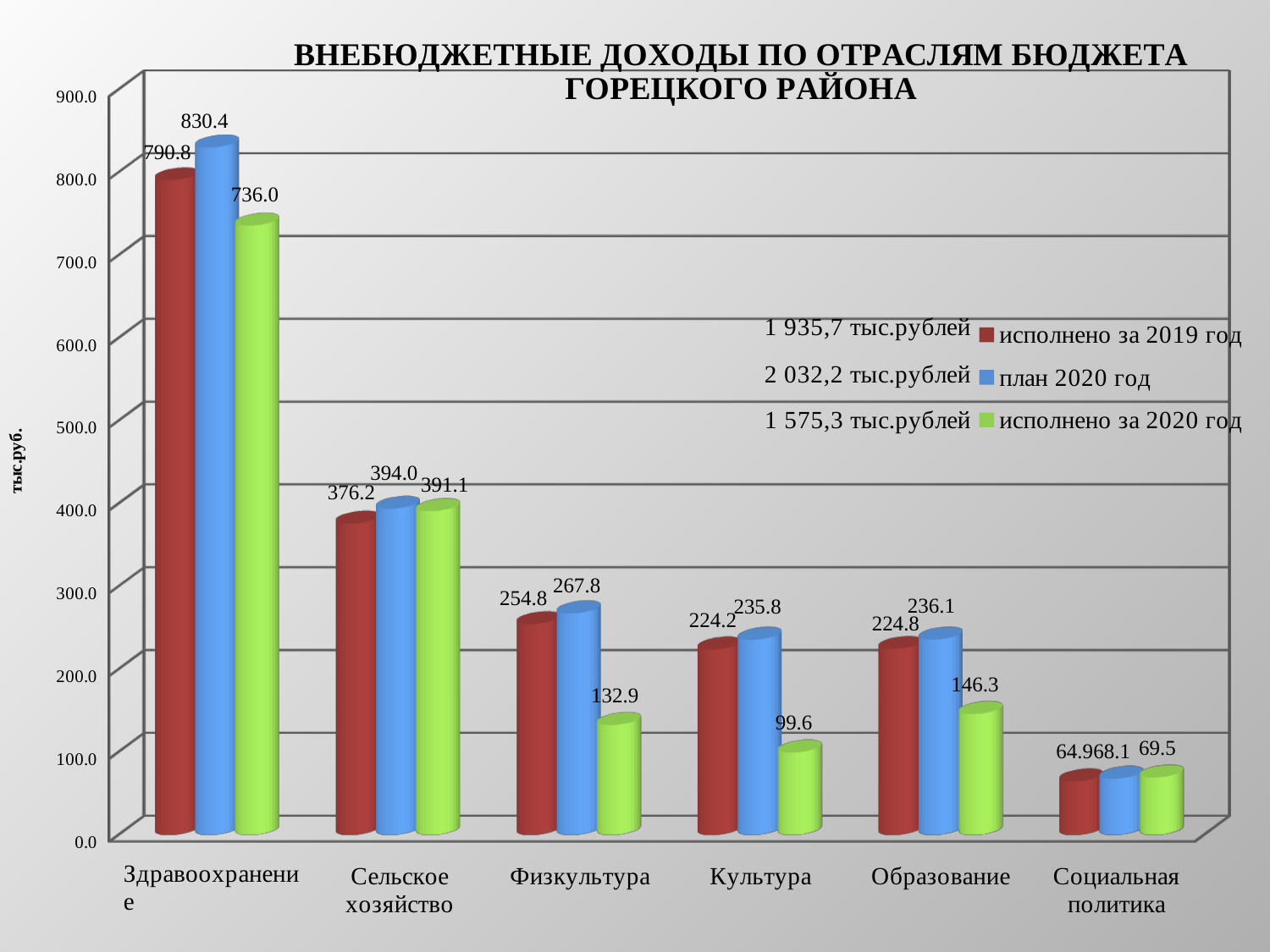
Which category has the lowest value in the series 'план 2020 год'? Социальная политика What is the value for Культура in the series 'исполнено за 2020 год'? 99.6 What is the value for Здравоохранение in the series 'план 2020 год'? 830.4 Which is larger for Сельское хозяйство: 'исполнено за 2019 год' or 'исполнено за 2020 год'? исполнено за 2020 год Which category has the highest value in the series 'исполнено за 2019 год'? Здравоохранение What kind of chart is shown on the slide? bar chart How many categories are shown on the x axis? 6 How many series does the legend list? 3 What is the difference between 'план 2020 год' and 'исполнено за 2020 год' for Физкультура? 134.9 What is the value for Здравоохранение in the series 'исполнено за 2020 год'? 736.0 What colour are the bars for the series 'план 2020 год'? blue What is the value for Образование in the series 'план 2020 год'? 236.1